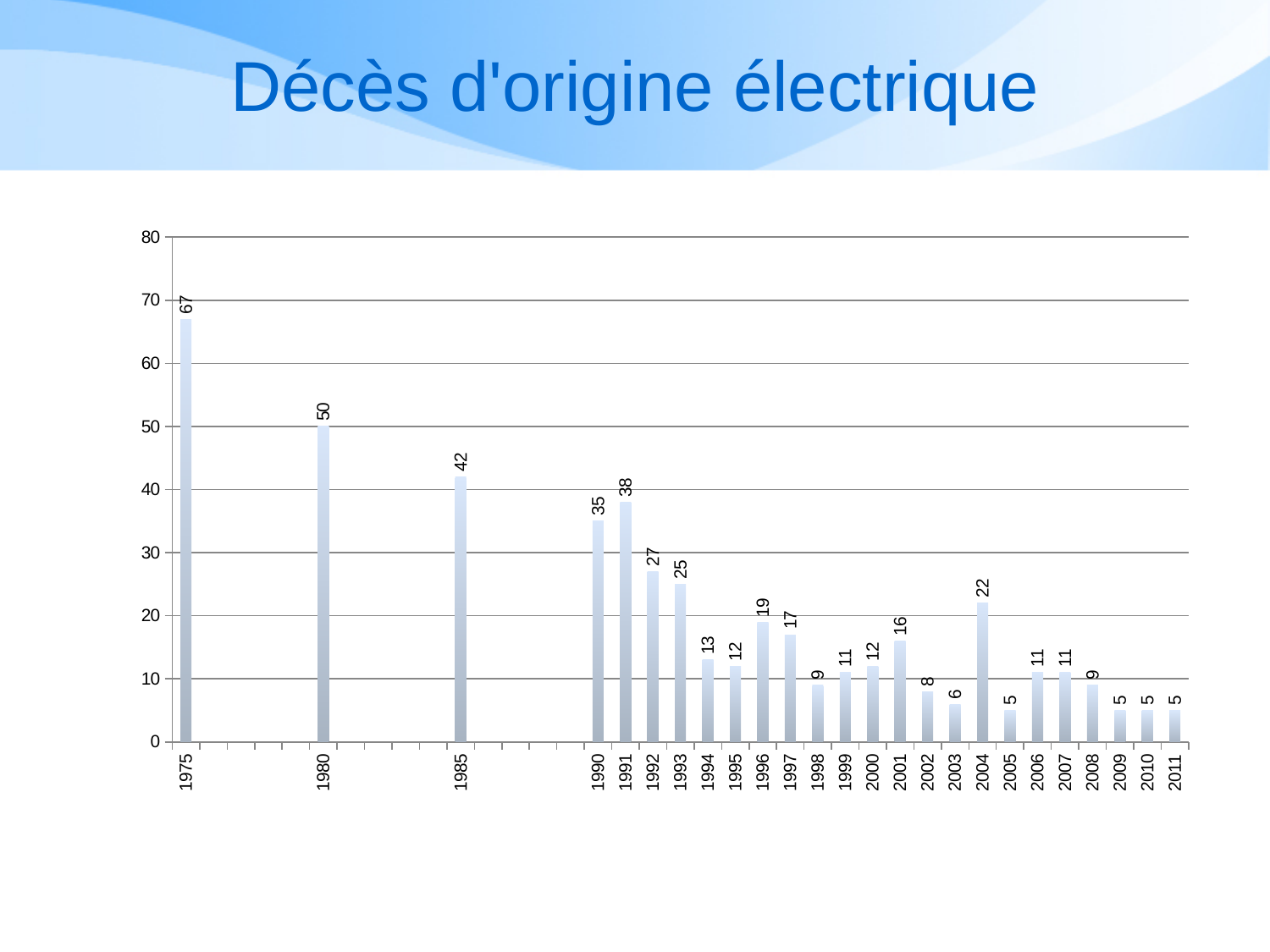
Is the value for 1985 greater or less than 40? greater Which year has the highest value? 1975 What is the difference between the values for 1990 and 1994? 22 What kind of chart is shown on the slide? bar chart What is the value for 2004? 22 What is the title of the chart? Décès d'origine électrique What is the value for 2003? 6 How many bars are plotted in the chart? 25 Which is larger, the value for 1996 or the value for 1997? 1996 What is the difference between the values for 1975 and 1980? 17 What is the value for 1991? 38 What is the value for 1975? 67